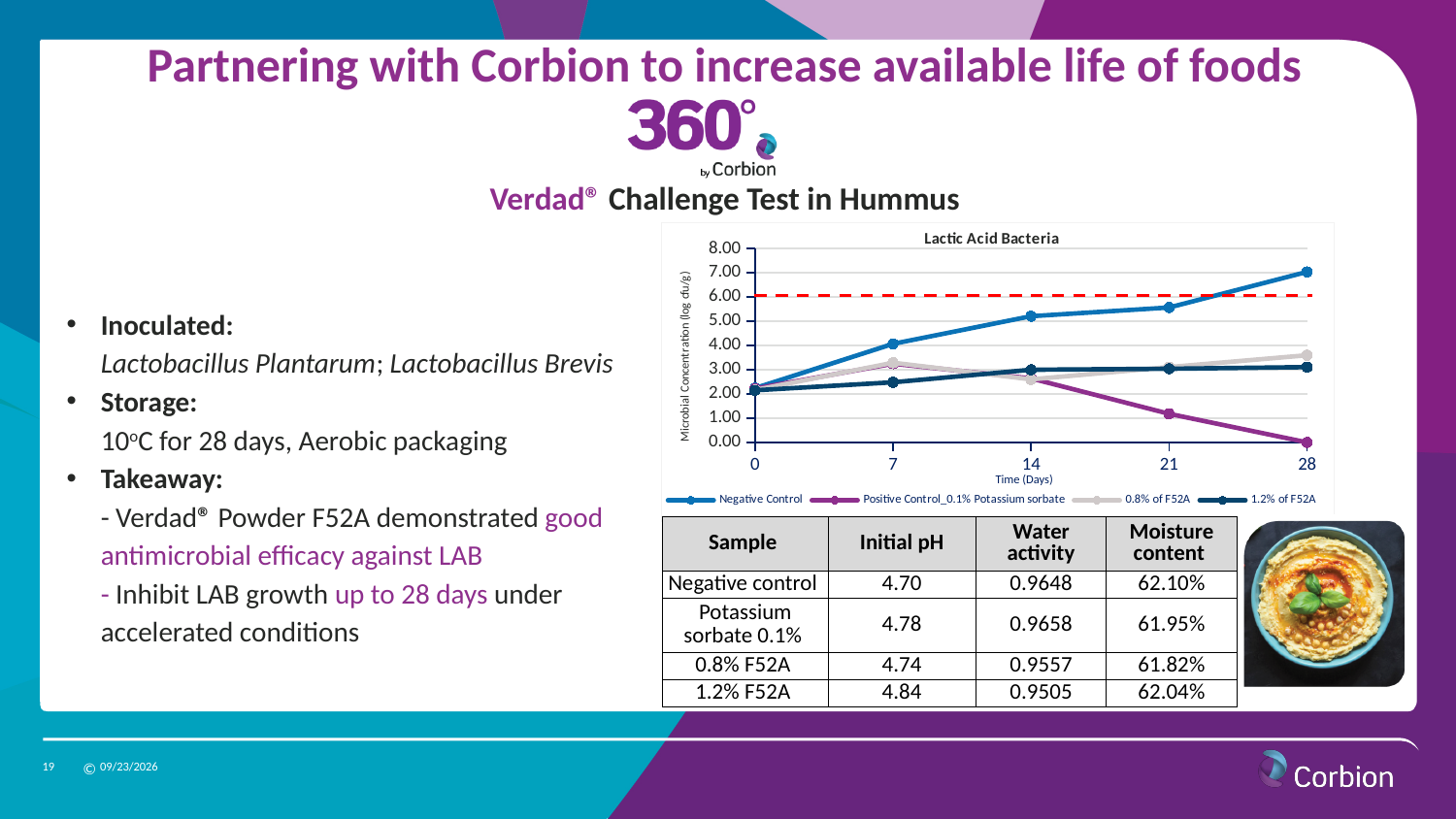
What kind of chart is the Lactic Acid Bacteria chart? Line chart In the Lactic Acid Bacteria chart, which series has the lowest value at day 28? Positive Control_0.1% Potassium sorbate How many series does the legend of the Lactic Acid Bacteria chart list? 4 In the Lactic Acid Bacteria chart, is the Positive Control_0.1% Potassium sorbate value at day 28 greater or less than 1.00? less In the Lactic Acid Bacteria chart, is the Negative Control value at day 7 greater or less than 3.00? greater In the Lactic Acid Bacteria chart, does the Positive Control_0.1% Potassium sorbate series rise or fall from day 7 to day 28? Fall In the Lactic Acid Bacteria chart, which series has the highest value at day 28? Negative Control In the Lactic Acid Bacteria chart, at day 28, which is larger: the Negative Control value or the 1.2% of F52A value? Negative Control What is the label of the y axis in the Lactic Acid Bacteria chart? Microbial Concentration (log cfu/g) How many time points are shown on the x axis of the Lactic Acid Bacteria chart? 5 In the Lactic Acid Bacteria chart, does the Negative Control series rise or fall from day 0 to day 28? Rise In the Lactic Acid Bacteria chart, is the Negative Control value at day 28 greater or less than 6.00? greater